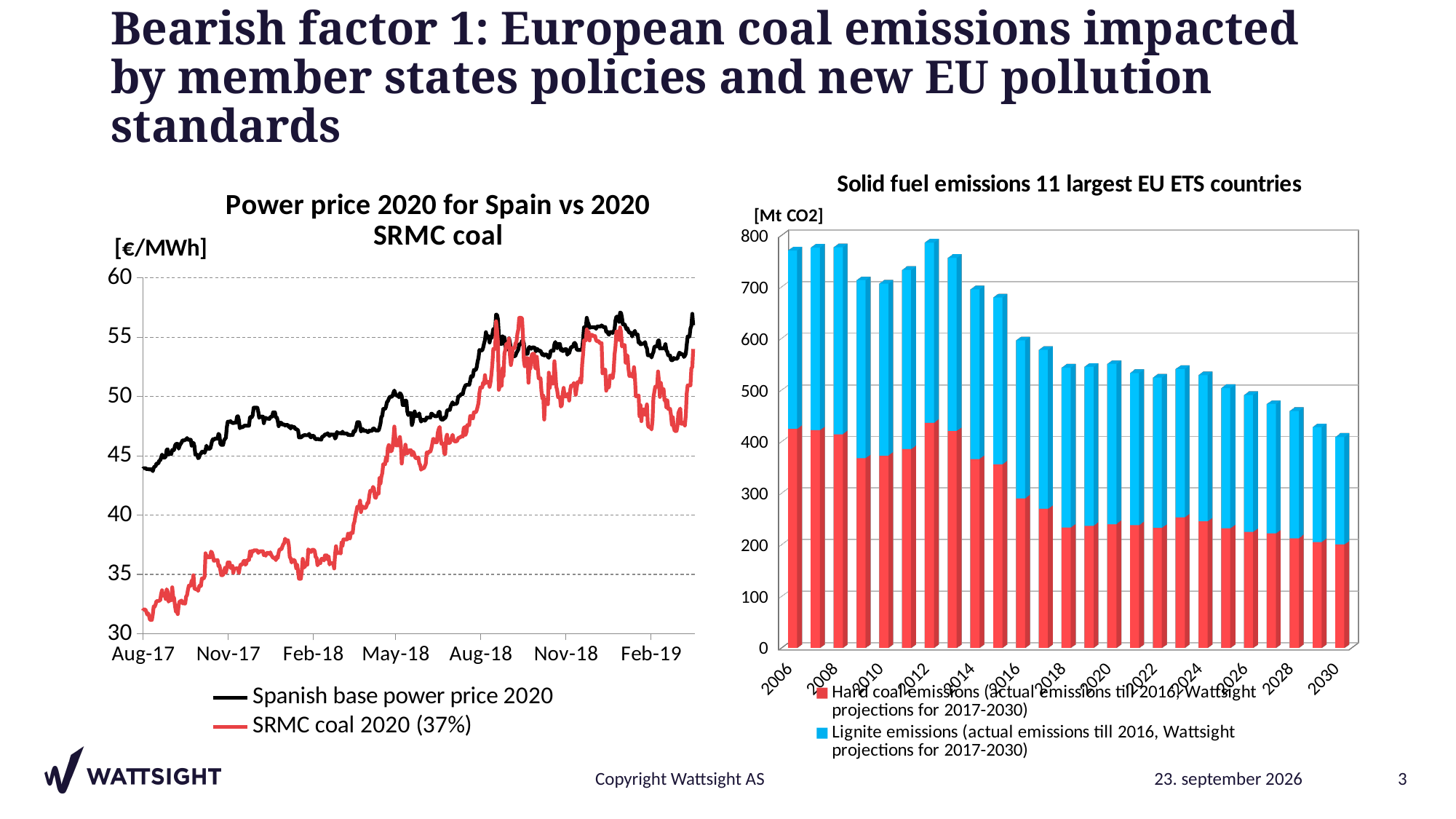
In the 'Power price 2020 for Spain vs 2020 SRMC coal' chart, which series is higher at Aug-17, the Spanish base power price 2020 or SRMC coal 2020? Spanish base power price 2020 How many series does the legend of the 'Solid fuel emissions 11 largest EU ETS countries' chart list? 2 In the 'Power price 2020 for Spain vs 2020 SRMC coal' chart, does the SRMC coal 2020 series overall rise or fall from Aug-17 to Feb-19? rise In the 'Power price 2020 for Spain vs 2020 SRMC coal' chart, is the SRMC coal 2020 value at Aug-17 greater or less than 35? less In the 'Solid fuel emissions 11 largest EU ETS countries' chart, which year has the lowest total emissions? 2030 In the 'Solid fuel emissions 11 largest EU ETS countries' chart, is the total emissions bar for 2030 greater or less than 500? less What kind of chart is the 'Power price 2020 for Spain vs 2020 SRMC coal' chart? line chart In the 'Power price 2020 for Spain vs 2020 SRMC coal' chart, is the Spanish base power price 2020 at Aug-17 greater or less than 50? less What kind of chart is the 'Solid fuel emissions 11 largest EU ETS countries' chart? bar chart How many series does the legend of the 'Power price 2020 for Spain vs 2020 SRMC coal' chart list? 2 What unit is shown on the y axis of the 'Solid fuel emissions 11 largest EU ETS countries' chart? Mt CO2